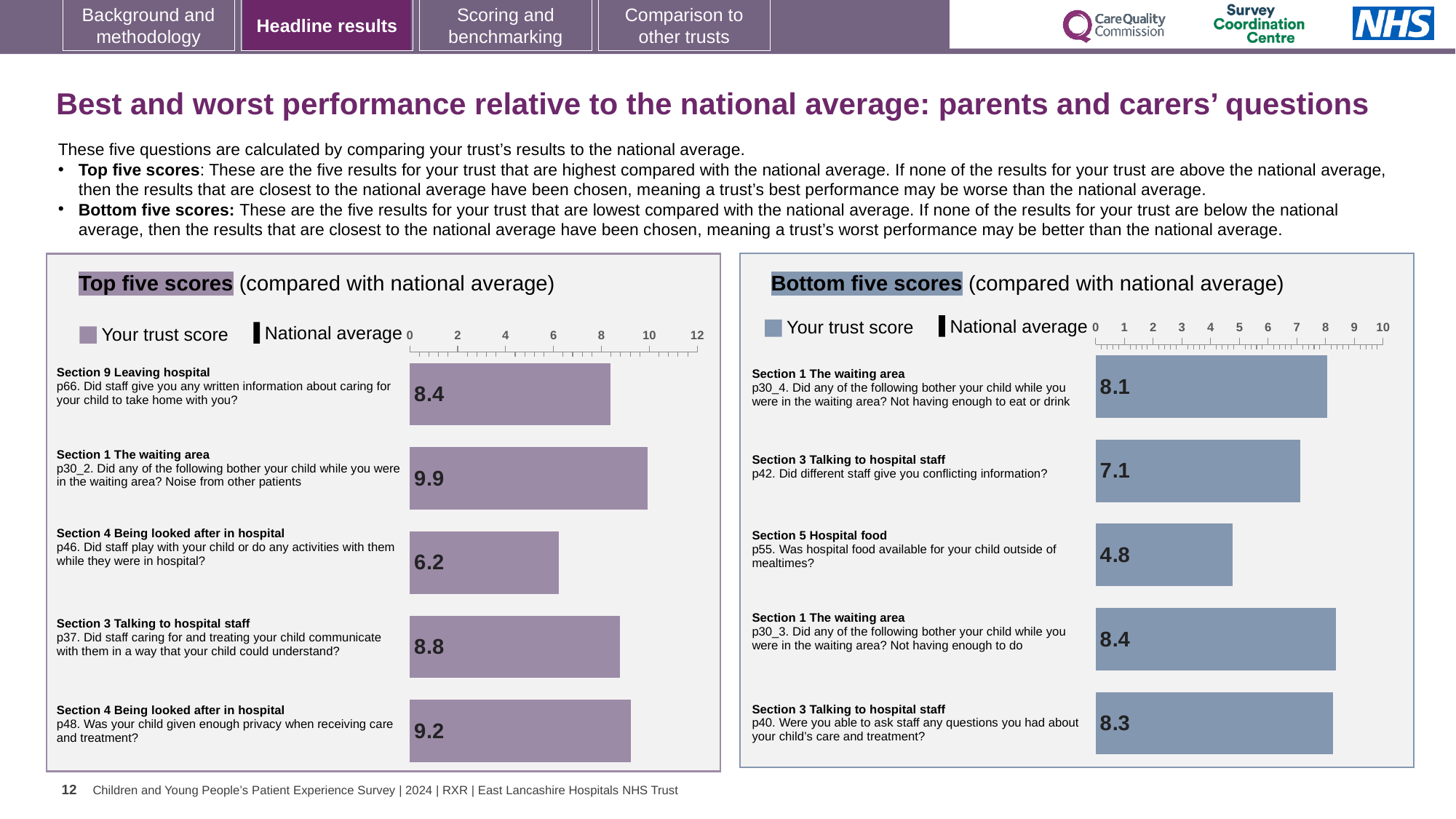
How many series does the legend of the Top five scores chart list? 2 In the Bottom five scores chart, which has the larger trust score: p30_4 (Not having enough to eat or drink) or p40 (able to ask staff any questions)? p40, 8.3 In the Top five scores chart, what is the trust score for p66 (written information about caring for your child to take home)? 8.4 In the Bottom five scores chart, which question has the highest trust score? p30_3 (Not having enough to do), 8.4 In the Top five scores chart, what is the difference between the trust scores for p30_2 and p46? 3.7 In the Bottom five scores chart, which question has the lowest trust score? p55 (Was hospital food available outside of mealtimes), 4.8 In the Top five scores chart, which question has the lowest trust score? p46 (Did staff play with your child or do any activities with them), 6.2 What type of chart is used for the Bottom five scores? Bar chart How many questions are plotted in the Top five scores chart? 5 In the Bottom five scores chart, what is the trust score for p42 (Did different staff give you conflicting information)? 7.1 In the Bottom five scores chart, what is the difference between the trust scores for p30_3 and p55? 3.6 In the Top five scores chart, which question has the highest trust score? p30_2 (Noise from other patients), 9.9